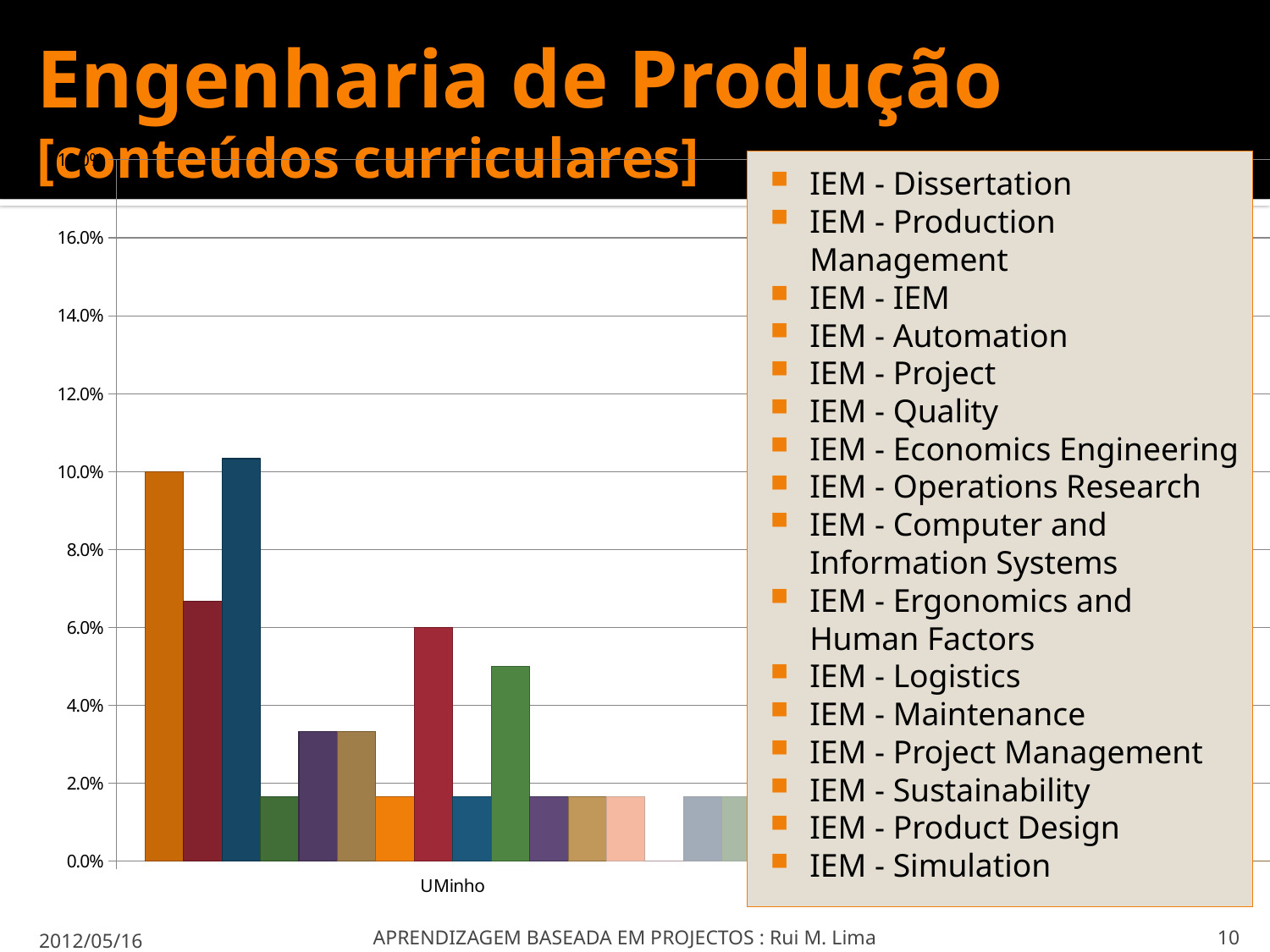
What kind of chart is shown on the slide? bar chart Is the value of the second (dark red) bar from the left greater or less than 6.0%? greater Is the value of the fourth (green) bar from the left greater or less than 2.0%? less What category label appears on the x axis of the chart? UMinho Is the value of the eighth (red) bar from the left greater or less than 4.0%? greater What is the title of the slide containing the chart? Engenharia de Produção [conteúdos curriculares] What is the lowest tick value shown on the y axis of the chart? 0.0%